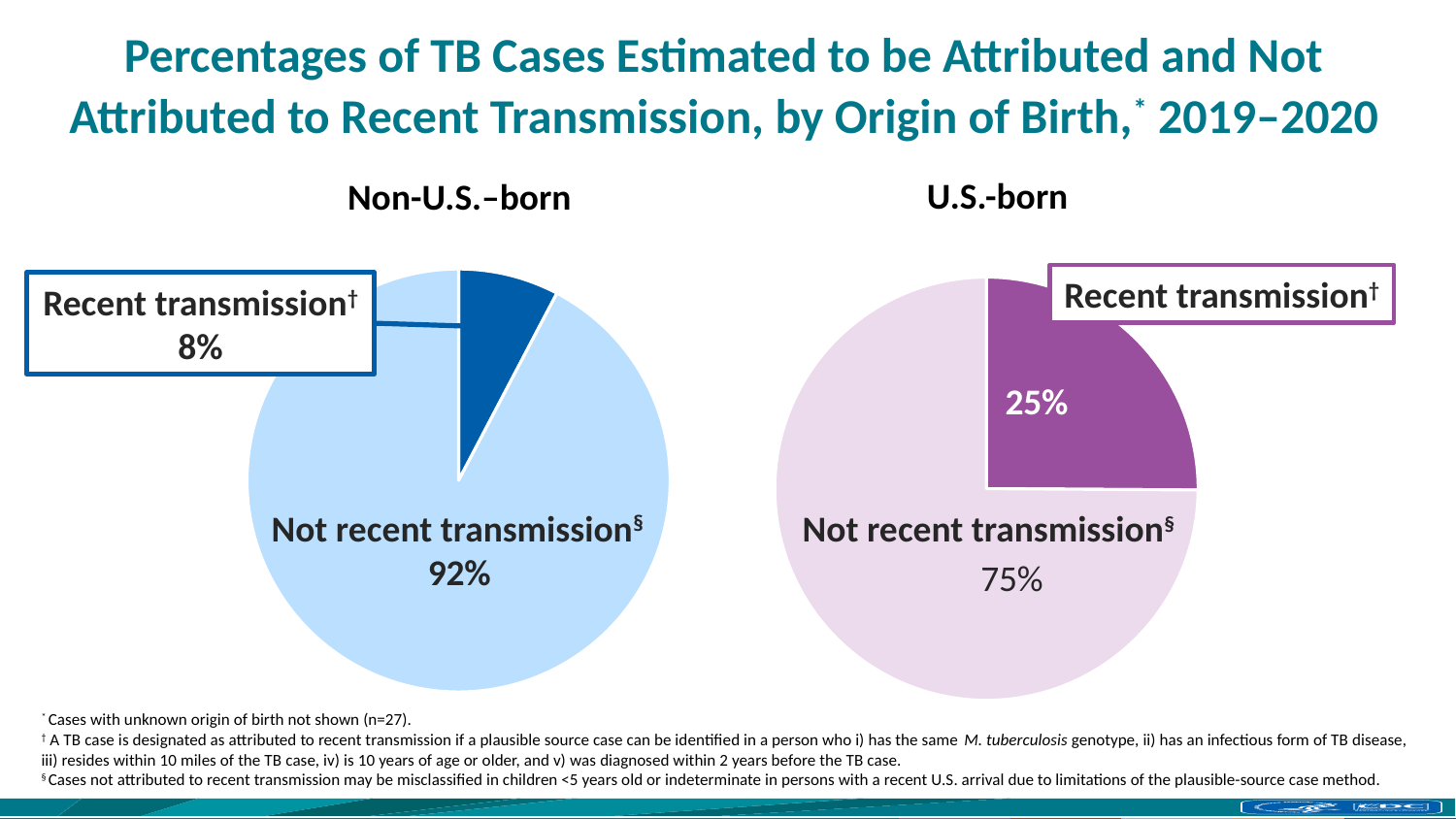
In the Non-U.S.-born pie chart, what percentage of TB cases is attributed to recent transmission? 8% In the U.S.-born pie chart, which slice is the largest? Not recent transmission How many slices does the Non-U.S.-born pie chart have? 2 In the Non-U.S.-born pie chart, what percentage of TB cases is not attributed to recent transmission? 92% What is the title of the pie chart on the right side of the slide? U.S.-born How many pie charts are shown on the slide? 2 In the Non-U.S.-born pie chart, which slice is the smallest? Recent transmission In the U.S.-born pie chart, what percentage of TB cases is not attributed to recent transmission? 75% What is the difference between the recent transmission percentage for U.S.-born cases and for Non-U.S.-born cases? 17 percentage points Which group has a larger share of TB cases attributed to recent transmission, U.S.-born or Non-U.S.-born? U.S.-born What type of chart is used on this slide? Pie chart In the U.S.-born pie chart, what percentage of TB cases is attributed to recent transmission? 25%